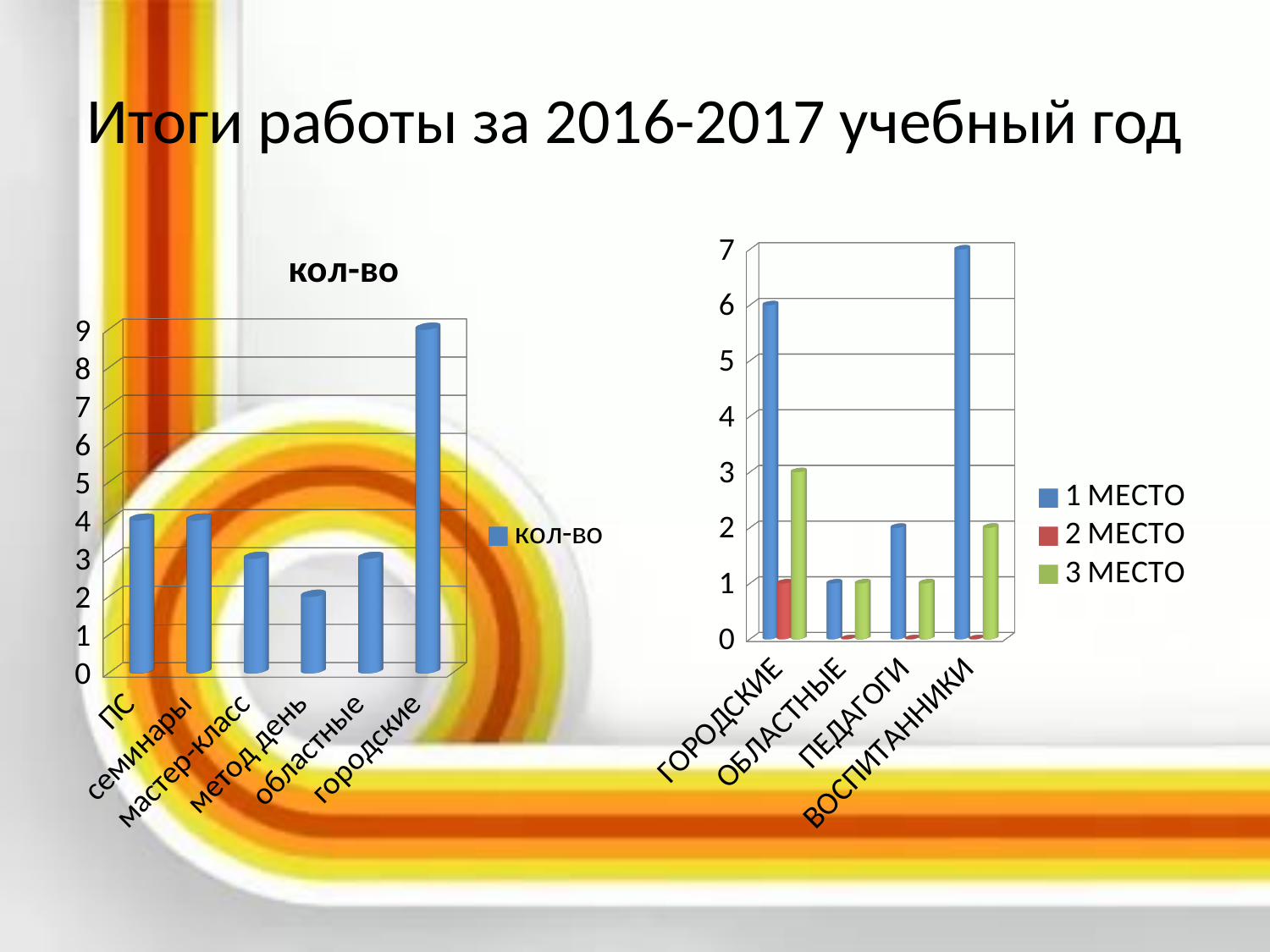
In the right chart, what are the three legend entries? 1 МЕСТО, 2 МЕСТО, 3 МЕСТО In the right chart, which is larger for ГОРОДСКИЕ: 2 МЕСТО or 3 МЕСТО? 3 МЕСТО In the left chart titled "кол-во", which category has the highest value? городские In the left chart titled "кол-во", is the value for метод день greater or less than 3? less In the left chart titled "кол-во", how many categories are shown on the x axis? 6 In the left chart titled "кол-во", is the value for городские greater or less than 8? greater In the right chart, how many series does the legend list? 3 What kind of chart is the left chart titled "кол-во"? bar chart In the left chart titled "кол-во", which is larger: the value for ПС or the value for мастер-класс? ПС In the left chart titled "кол-во", which category has the lowest value? метод день In the right chart, which category has the highest value for 1 МЕСТО? ВОСПИТАННИКИ In the right chart, is the value for 1 МЕСТО in ГОРОДСКИЕ greater or less than 5? greater